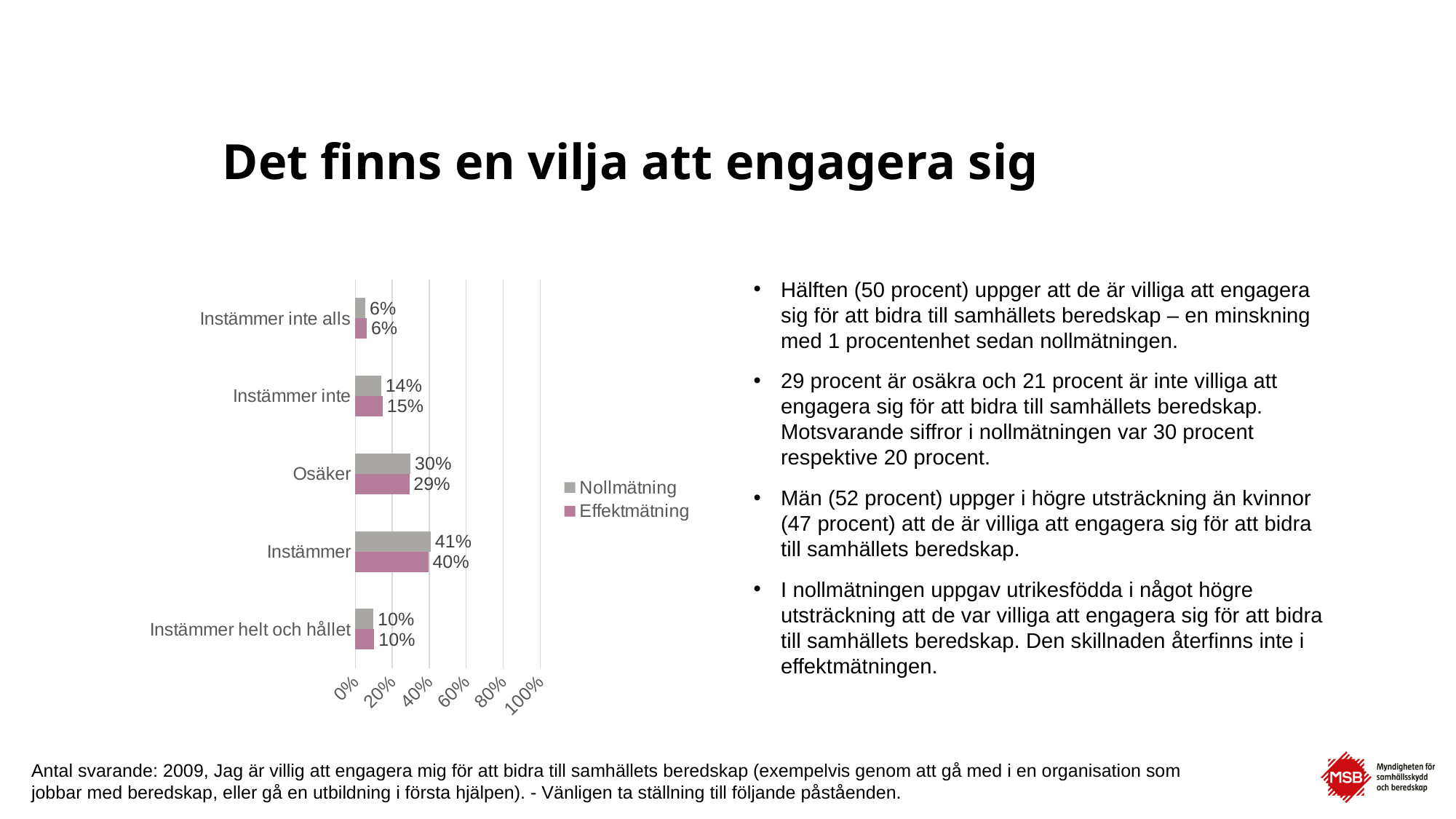
What is the Effektmätning value for Instämmer? 40% What is the Nollmätning value for Osäker? 30% How many series does the legend list? 2 What kind of chart is shown on the slide? Bar chart What are the two series named in the legend? Nollmätning and Effektmätning Which category has the lowest Nollmätning value? Instämmer inte alls Which is larger for Osäker: the Nollmätning value or the Effektmätning value? Nollmätning What is the difference between the Nollmätning and Effektmätning values for Instämmer inte? 1% Which category has the highest Effektmätning value? Instämmer What is the Nollmätning value for Instämmer helt och hållet? 10% How many categories are shown on the chart? 5 What is the Effektmätning value for Instämmer inte? 15%